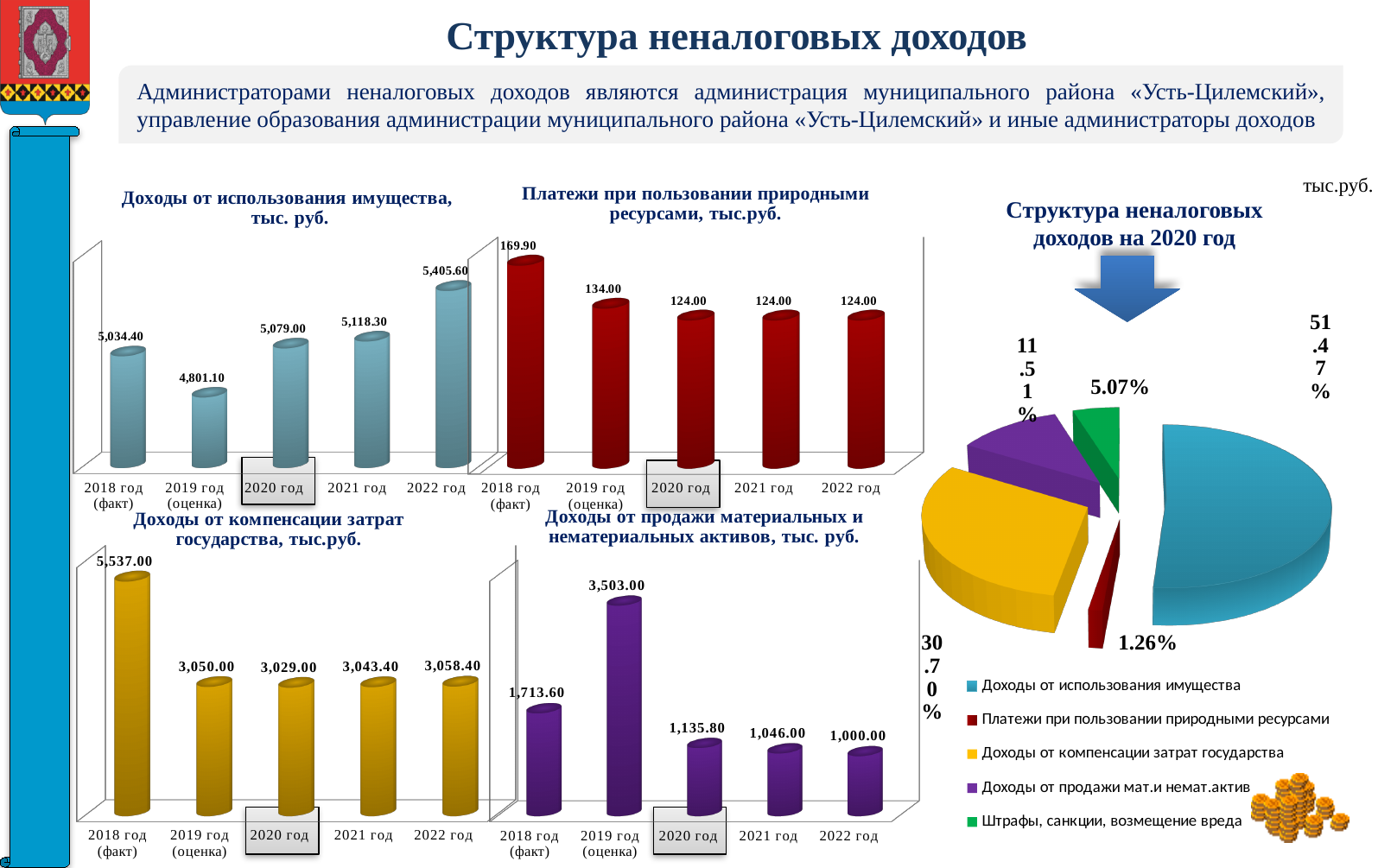
In the chart 'Доходы от компенсации затрат государства, тыс.руб.', what is the value for 2020 год? 3,029.00 How many entries does the legend of the pie chart 'Структура неналоговых доходов на 2020 год' list? 5 In the chart 'Платежи при пользовании природными ресурсами, тыс.руб.', what is the value for 2018 год (факт)? 169.90 In the chart 'Платежи при пользовании природными ресурсами, тыс.руб.', what is the difference between the 2018 год (факт) and 2019 год (оценка) values? 35.90 In the chart 'Доходы от использования имущества, тыс. руб.', which year has the lowest value? 2019 год (оценка) In the chart 'Доходы от продажи материальных и нематериальных активов, тыс. руб.', do the values rise or fall from 2019 год to 2022 год? fall In the chart 'Доходы от продажи материальных и нематериальных активов, тыс. руб.', which is larger: the value for 2018 год (факт) or 2020 год? 2018 год (факт) In the chart 'Доходы от компенсации затрат государства, тыс.руб.', which year has the highest value? 2018 год (факт) What kind of chart is 'Доходы от использования имущества, тыс. руб.'? bar chart In the chart 'Доходы от продажи материальных и нематериальных активов, тыс. руб.', what is the value for 2019 год (оценка)? 3,503.00 In the pie chart 'Структура неналоговых доходов на 2020 год', what share does 'Доходы от использования имущества' have? 51.47% In the chart 'Доходы от использования имущества, тыс. руб.', what is the value for 2022 год? 5,405.60